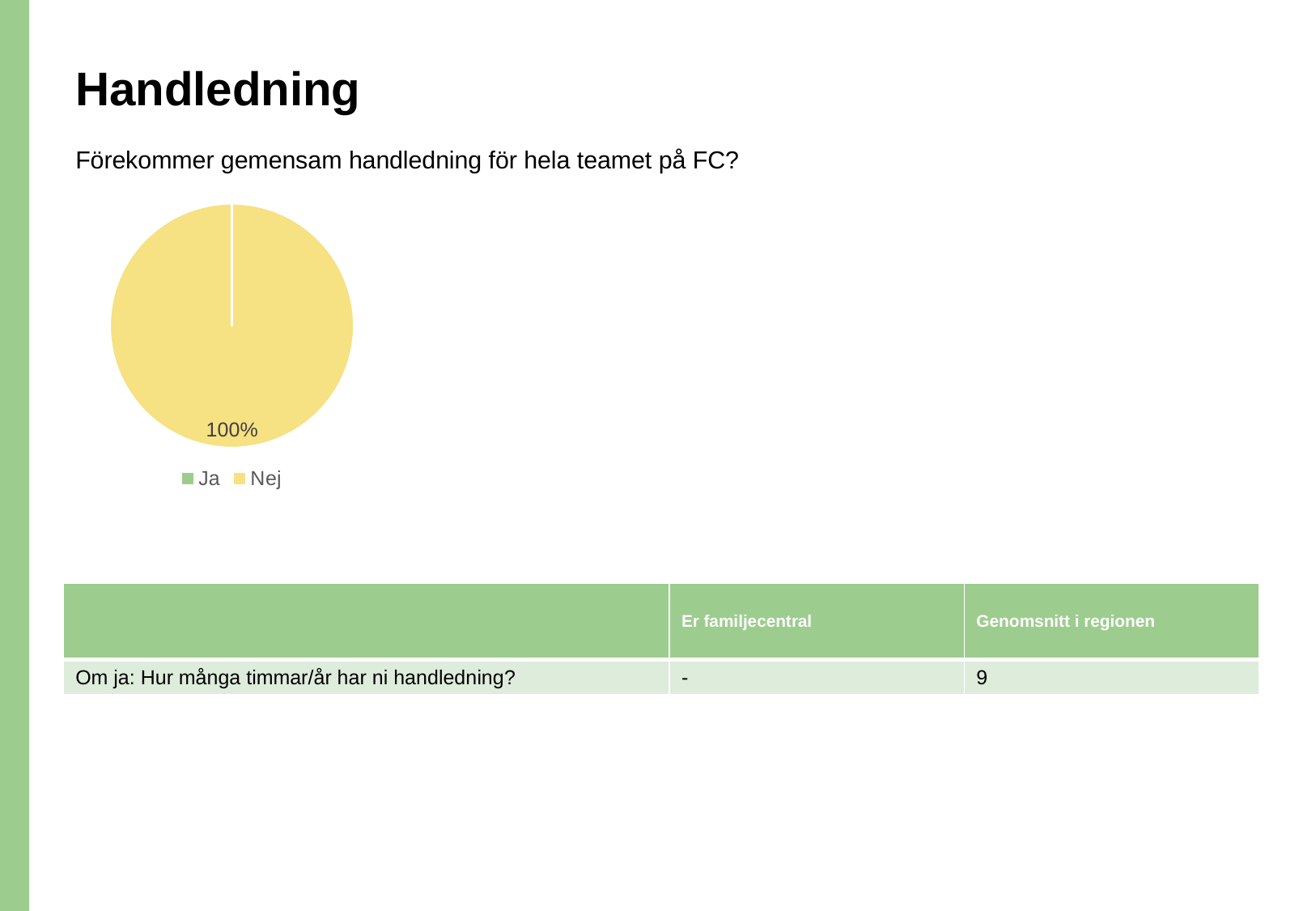
What share of the pie does the Nej slice represent? 100% What colour is the Nej slice in the pie chart? yellow What kind of chart is shown on the slide? pie chart What question does the pie chart answer, according to the text above it? Förekommer gemensam handledning för hela teamet på FC? How many entries does the legend of the pie chart list? 2 Which category has the smaller share of the pie, Ja or Nej? Ja Which is larger in the pie chart, Ja or Nej? Nej Which category has the largest share of the pie? Nej What is the only percentage label printed on the pie chart? 100%